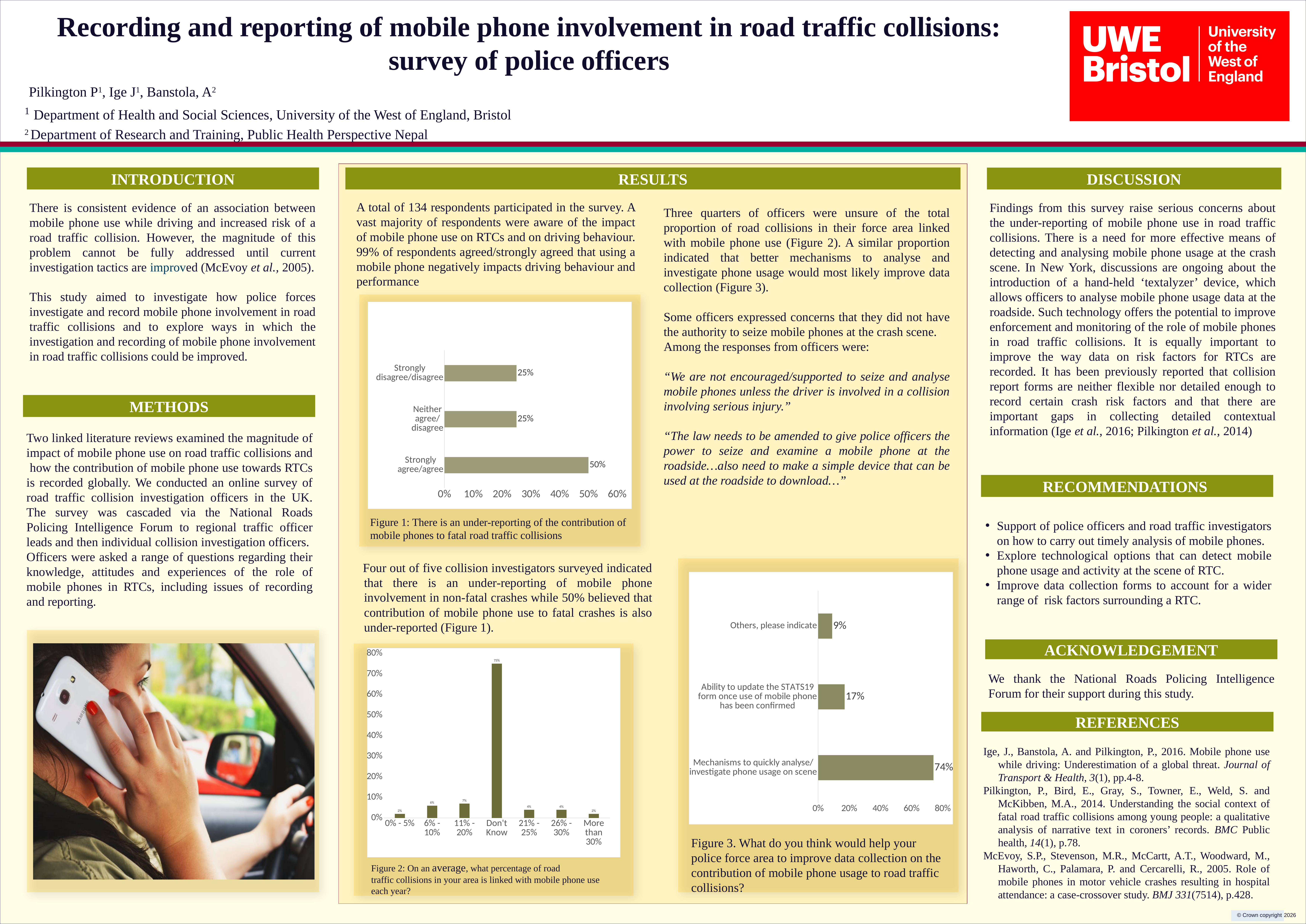
What kind of chart is Figure 2? bar chart In Figure 1, what is the value for Strongly agree/agree? 50% In Figure 1, what is the difference between Strongly agree/agree and Strongly disagree/disagree? 25% In Figure 1, what is the value for Neither agree/disagree? 25% In Figure 2, is the value for Don't Know greater or less than 70%? greater In Figure 1, which category has the highest value? Strongly agree/agree In Figure 3, what is the value for Mechanisms to quickly analyse/investigate phone usage on scene? 74% In Figure 3, what is the value for Others, please indicate? 9% In Figure 2, which category has the highest value? Don't Know In Figure 2, how many categories are shown on the x axis? 7 In Figure 1, how many categories are shown? 3 In Figure 3, what is the difference between Mechanisms to quickly analyse/investigate phone usage on scene and Ability to update the STATS19 form once use of mobile phone has been confirmed? 57%